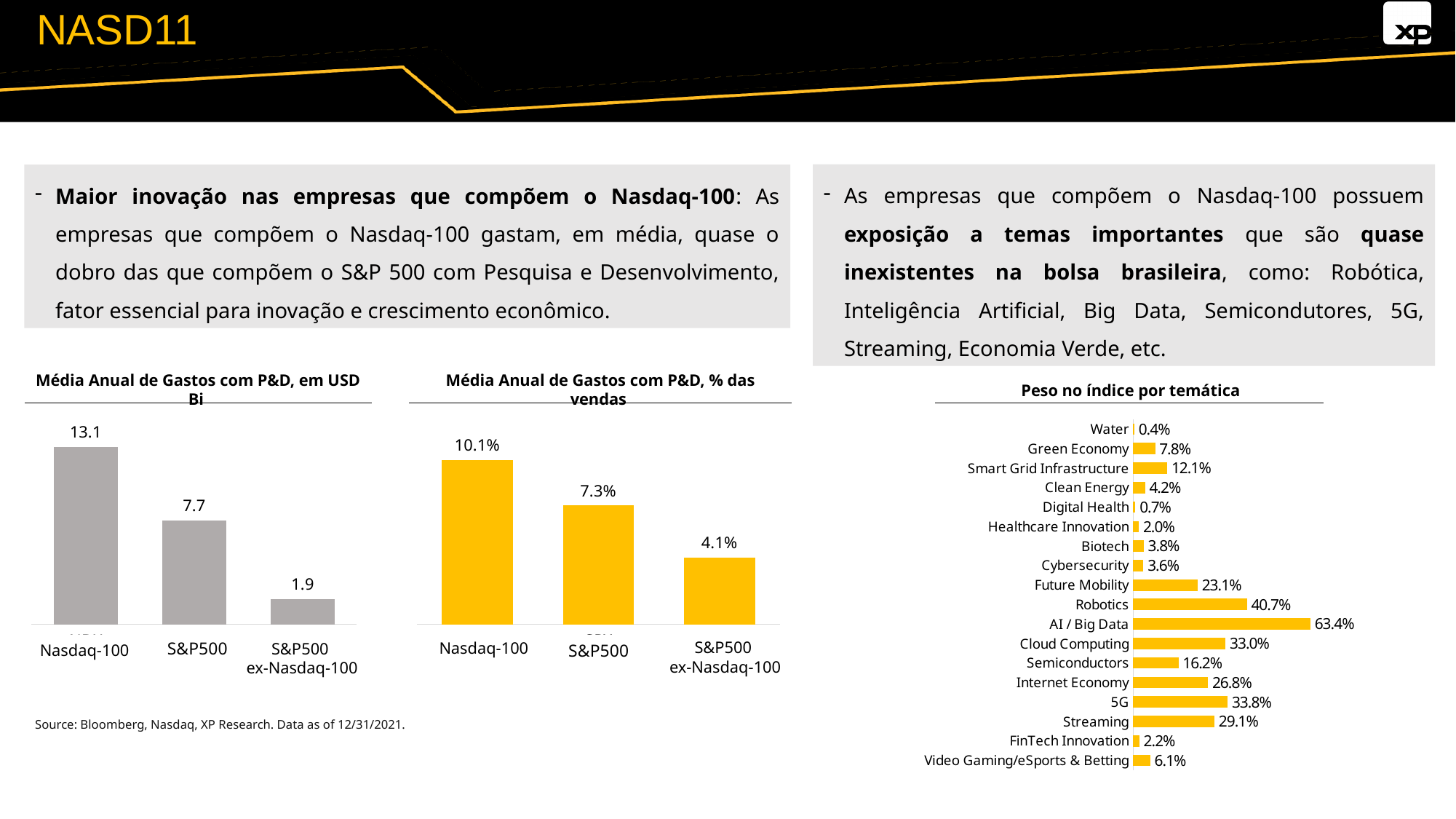
In the chart 'Peso no índice por temática', what is the value for Robotics? 40.7% In the chart 'Média Anual de Gastos com P&D, % das vendas', what is the value for S&P500? 7.3% In the chart 'Peso no índice por temática', which is larger, 5G or Cloud Computing? 5G What kind of chart is 'Peso no índice por temática'? Bar chart In the chart 'Média Anual de Gastos com P&D, em USD Bi', what is the difference between Nasdaq-100 and S&P500? 5.4 In the chart 'Peso no índice por temática', how many categories are shown? 18 In the chart 'Peso no índice por temática', which category has the highest value? AI / Big Data In the chart 'Peso no índice por temática', which category has the lowest value? Water In the chart 'Média Anual de Gastos com P&D, % das vendas', which category has the lowest value? S&P500 ex-Nasdaq-100 In the chart 'Média Anual de Gastos com P&D, em USD Bi', what is the value for Nasdaq-100? 13.1 In the chart 'Média Anual de Gastos com P&D, em USD Bi', what is the value for S&P500 ex-Nasdaq-100? 1.9 In the chart 'Média Anual de Gastos com P&D, % das vendas', how many categories are shown? 3